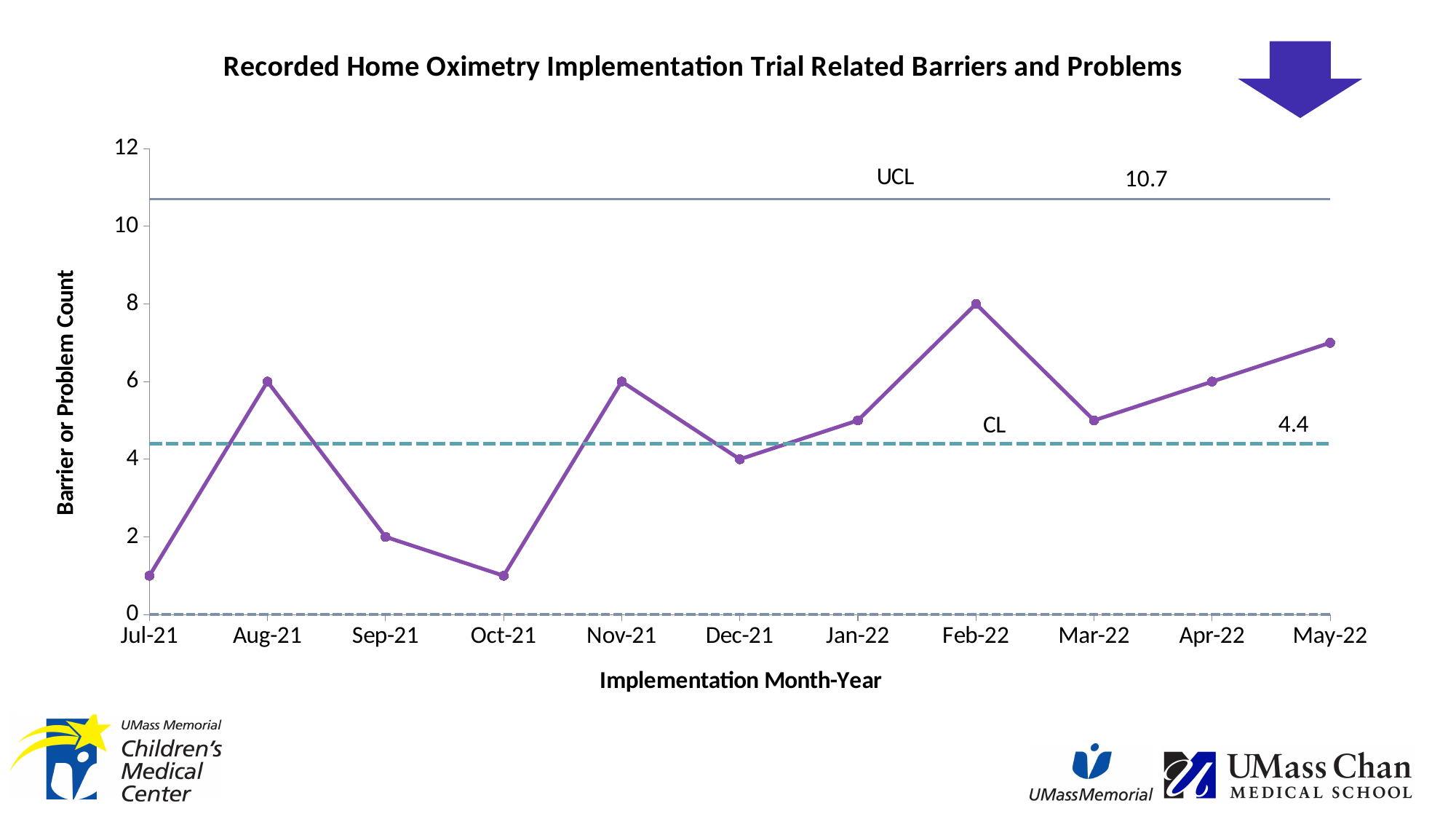
What is the value of the UCL line? 10.7 What is the difference between the barrier or problem counts for Feb-22 and Sep-21? 6 What is the value of the CL line? 4.4 How many months are plotted on the x axis? 11 What type of chart is shown on the slide? line chart What is the barrier or problem count for Sep-21? 2 What is the barrier or problem count for Dec-21? 4 What is the title of the chart? Recorded Home Oximetry Implementation Trial Related Barriers and Problems Which is larger, the value for Aug-21 or the value for Mar-22? Aug-21 Is the value for Jul-21 greater or less than 2? less What is the barrier or problem count for Feb-22? 8 Which month has the highest barrier or problem count? Feb-22